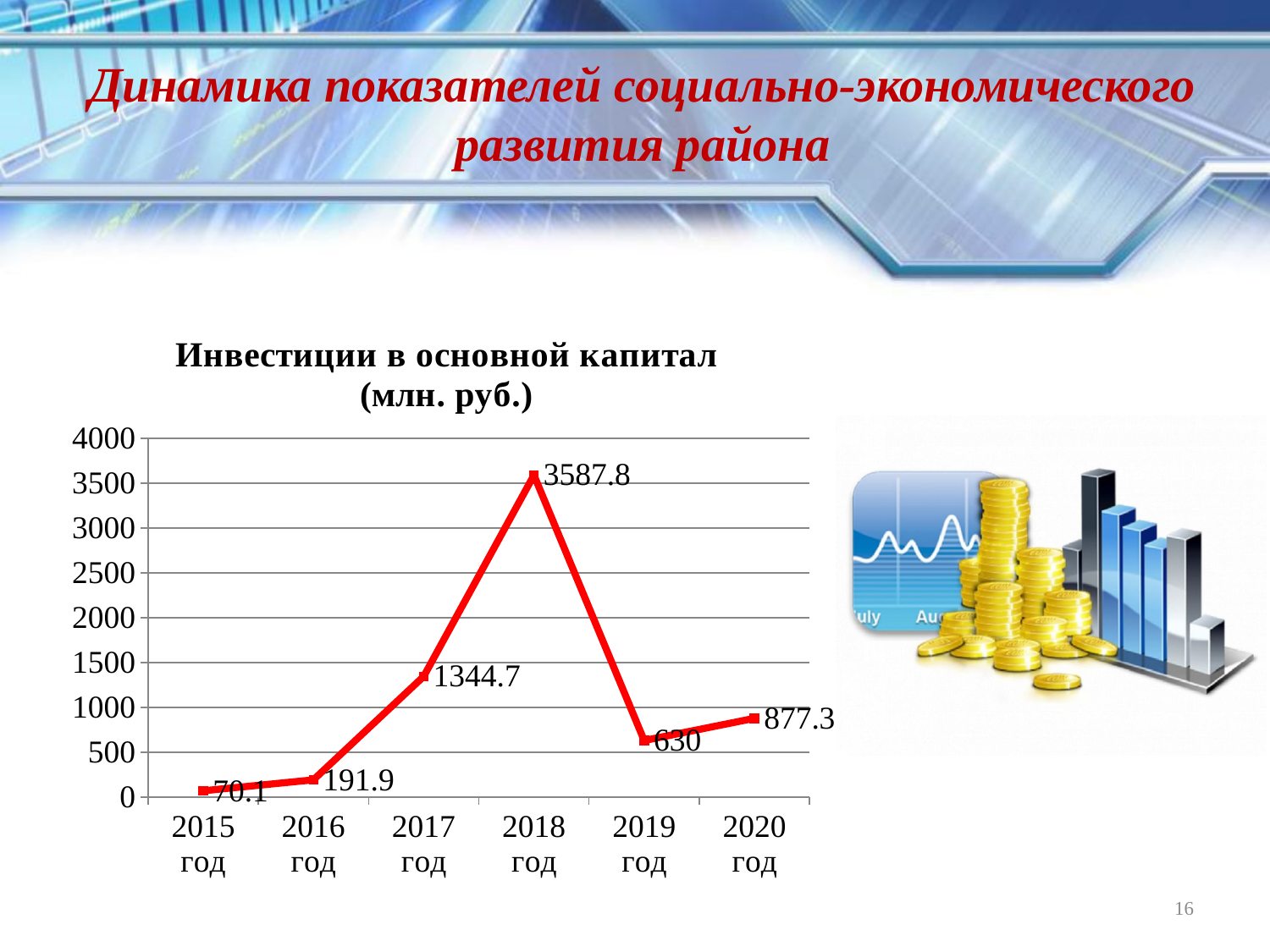
Which year has the highest value? 2018 год What is the title of the chart? Инвестиции в основной капитал (млн. руб.) What is the value for 2018 год? 3587.8 What is the value for 2019 год? 630 What is the value for 2015 год? 70.1 How many years are plotted on the chart? 6 Does the value rise or fall from 2018 год to 2019 год? fall What type of chart is shown on the slide? line chart Which is larger, the value for 2019 год or the value for 2020 год? 2020 год What is the difference between the values for 2018 год and 2017 год? 2243.1 What is the value for 2020 год? 877.3 Which year has the lowest value? 2015 год